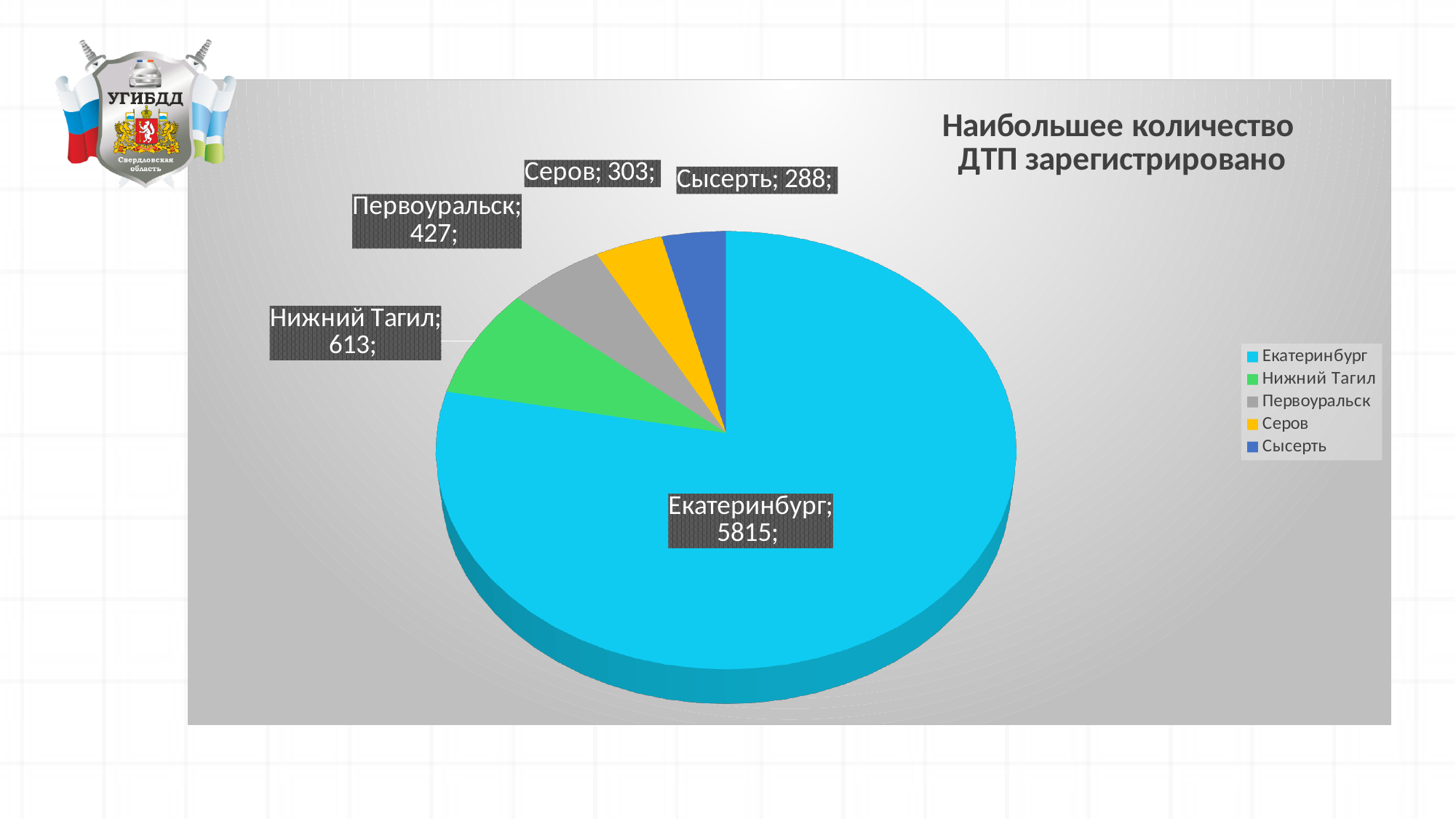
How many slices does the pie chart have? 5 What is the difference between the values for Нижний Тагил and Первоуральск? 186 What is the value for Первоуральск? 427 What is the value for Нижний Тагил? 613 Which category has the largest slice? Екатеринбург What is the value for Екатеринбург? 5815 Which category has the smallest slice? Сысерть How many entries does the legend list? 5 What is the title of the chart? Наибольшее количество ДТП зарегистрировано What is the value for Сысерть? 288 Which is larger, the value for Серов or the value for Сысерть? Серов What kind of chart is shown on the slide? Pie chart